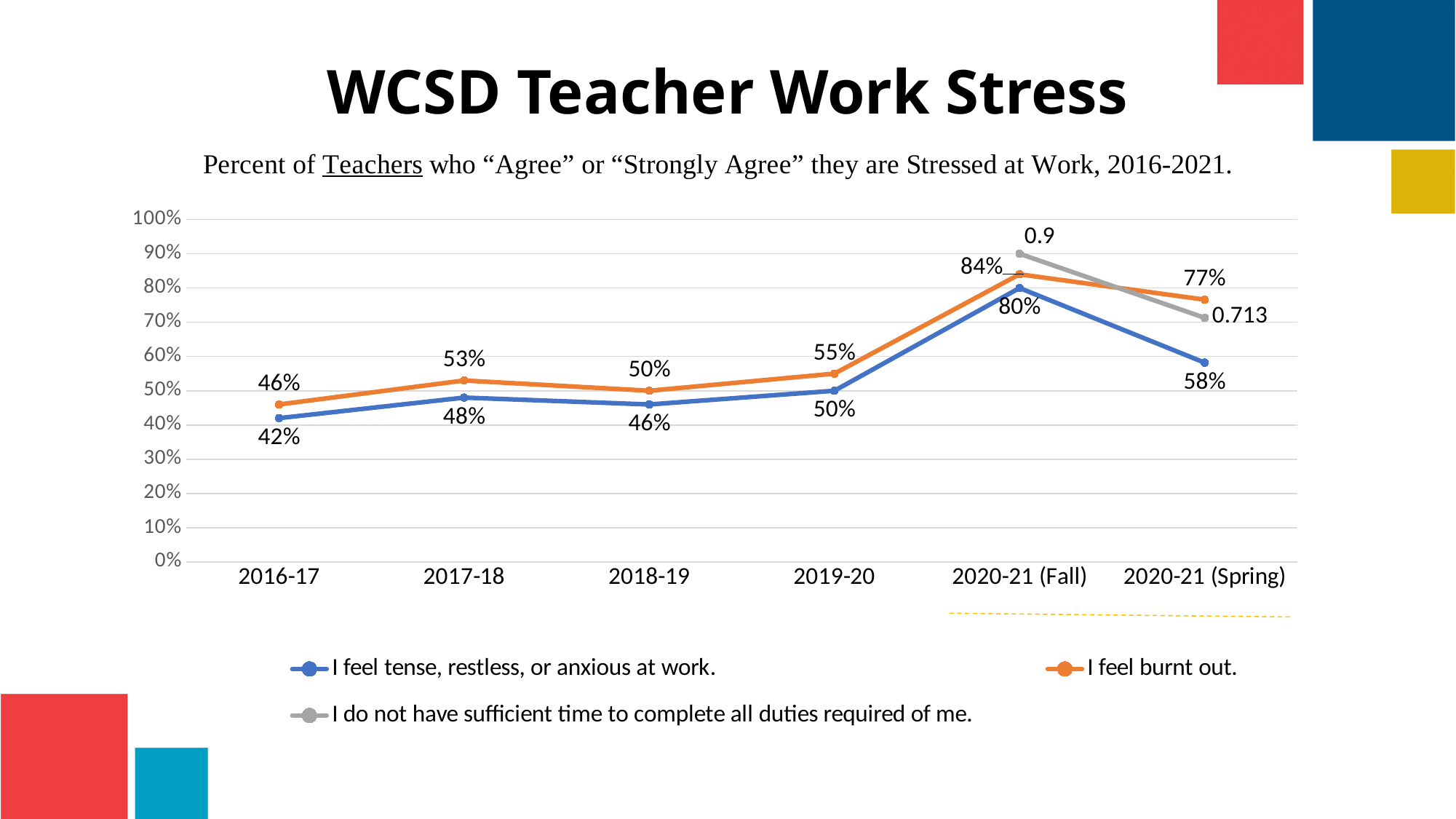
In which period is the value for "I feel burnt out." lowest? 2016-17 Which is larger in 2019-20: "I feel burnt out." or "I feel tense, restless, or anxious at work."? I feel burnt out. What is the difference between the "I feel burnt out." values in 2020-21 (Fall) and 2020-21 (Spring)? 7% What is the value for "I do not have sufficient time to complete all duties required of me." in 2020-21 (Spring)? 0.713 How many time periods are shown on the x axis? 6 What is the value for "I feel burnt out." in 2020-21 (Fall)? 84% What type of chart is shown on the slide? line chart In which period is the value for "I feel tense, restless, or anxious at work." highest? 2020-21 (Fall) What colour is the line for "I feel burnt out."? orange What is the value for "I feel tense, restless, or anxious at work." in 2016-17? 42% How many series does the legend list? 3 Does the value for "I feel tense, restless, or anxious at work." rise or fall from 2020-21 (Fall) to 2020-21 (Spring)? fall